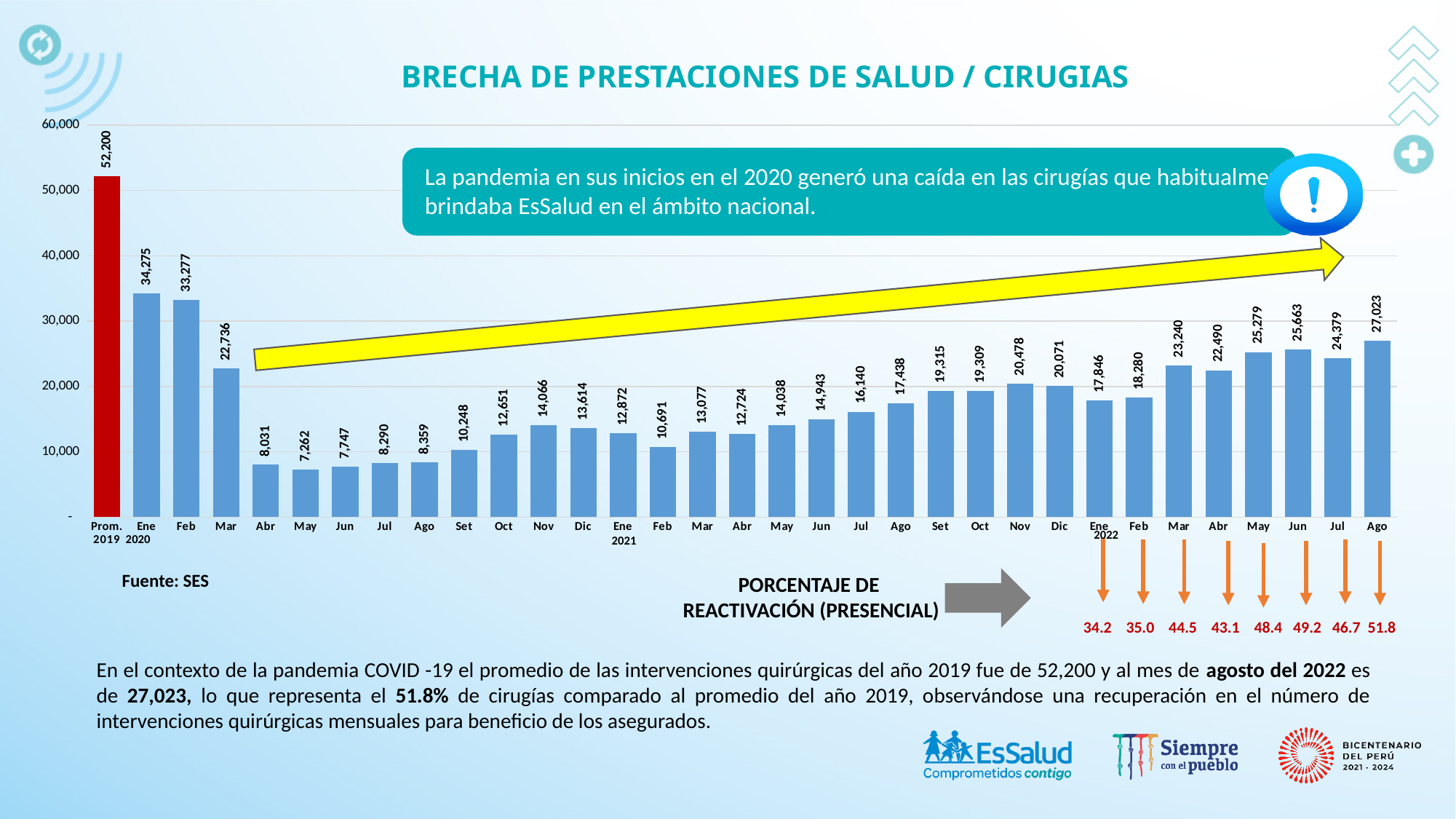
What kind of chart is shown on the slide? bar chart Which is larger, Mar 2022 or Abr 2022? Mar 2022 What is the value for Prom. 2019? 52,200 What is the difference between Prom. 2019 and Ago 2022? 25,177 Is the value for Ene 2020 greater or less than 30,000? greater How many bars are plotted in the chart? 33 Which category has the highest value? Prom. 2019 What is the value for May 2020? 7,262 What is the difference between Ago 2022 and Jul 2022? 2,644 What is the value for Ago 2022? 27,023 What is the value for Set 2021? 19,315 Which category has the lowest value? May 2020